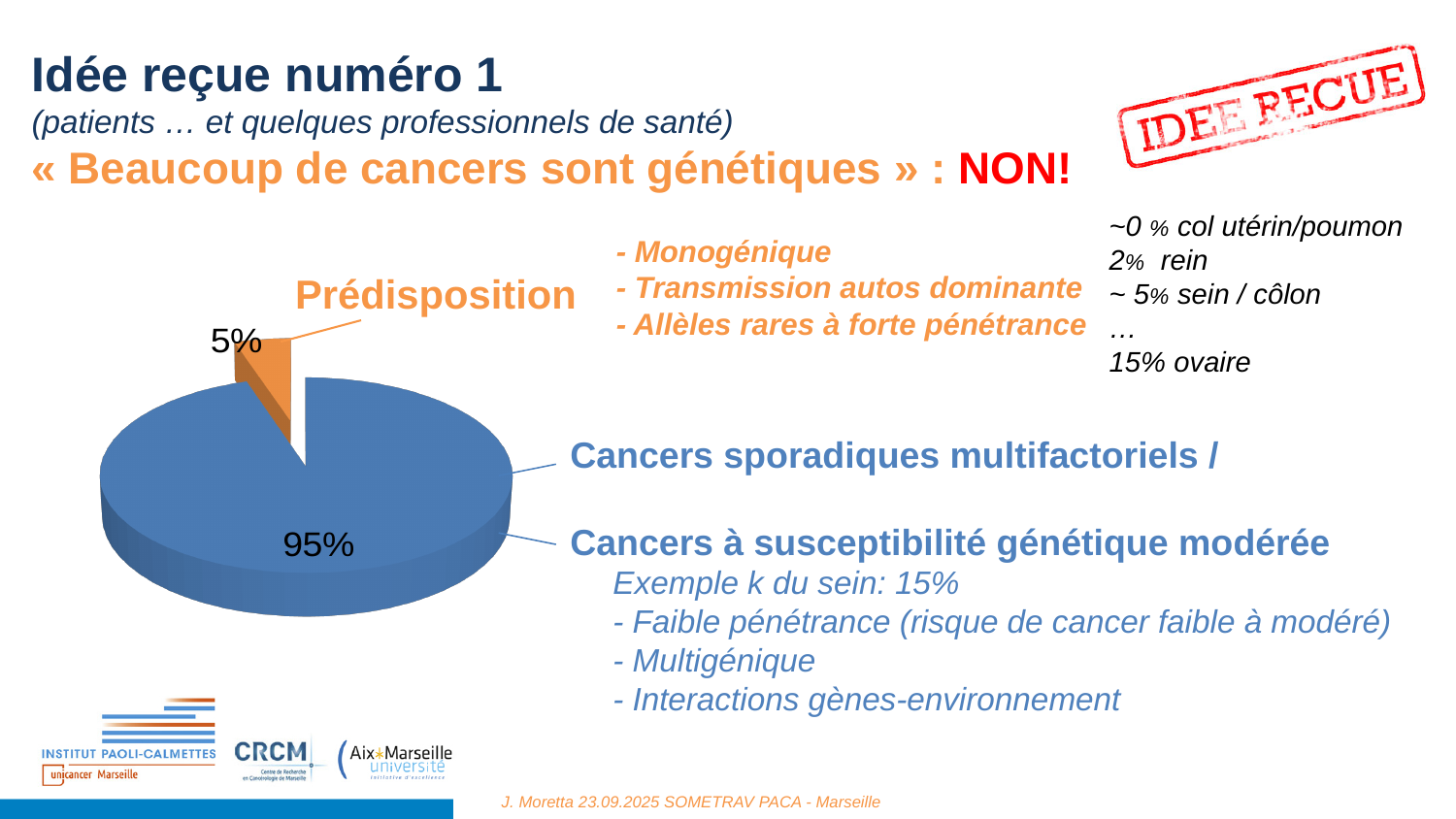
Which slice of the pie chart is the largest? 95% What percentage is shown for the Prédisposition slice of the pie chart? 5% What is the difference in percentage points between the two slices of the pie chart? 90 Is the value of the Prédisposition slice greater or less than 10%? less How many slices does the pie chart have? 2 What percentage is shown for the large blue slice of the pie chart? 95% What colour is the Prédisposition slice in the pie chart? orange Which slice of the pie chart is the smallest? Prédisposition (5%) What kind of chart is shown on the slide? pie chart What share of the pie does the Prédisposition slice represent? 5% Which is larger in the pie chart: the Prédisposition slice or the blue slice? the blue slice What colour is the 95% slice in the pie chart? blue